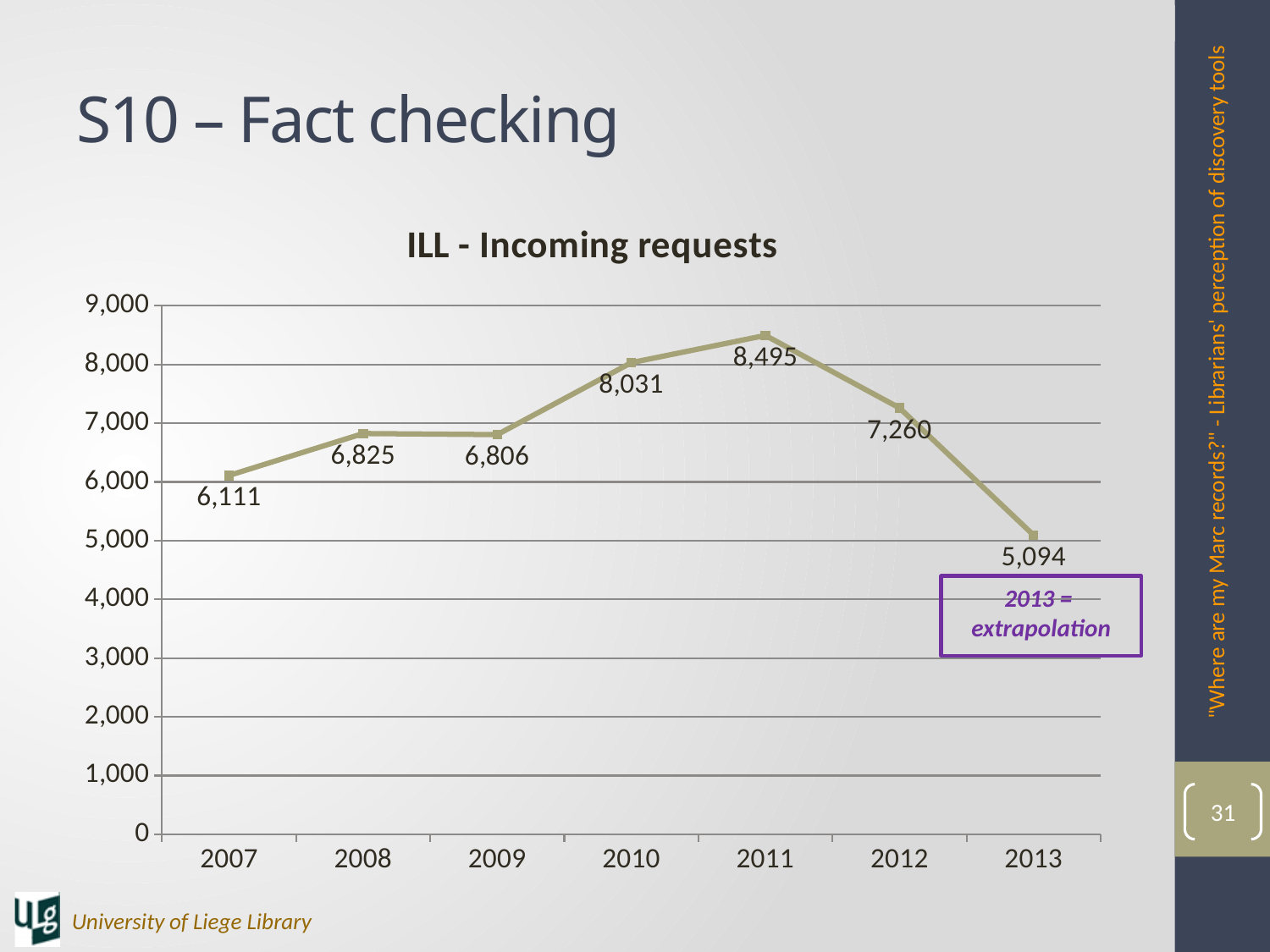
What kind of chart is shown on the slide? line chart Which year has the lowest number of incoming requests? 2013 Which year has the highest number of incoming requests? 2011 Is the value for 2010 greater or less than 8,000? greater What is the value for 2013 in the ILL - Incoming requests chart? 5,094 What is the difference between the values for 2011 and 2012? 1,235 What is the value for 2011 in the ILL - Incoming requests chart? 8,495 Do the values rise or fall from 2011 to 2013? fall What is the title of the chart? ILL - Incoming requests How many years are plotted on the x axis of the chart? 7 Which year has a larger value, 2008 or 2009? 2008 What is the value for 2007 in the ILL - Incoming requests chart? 6,111